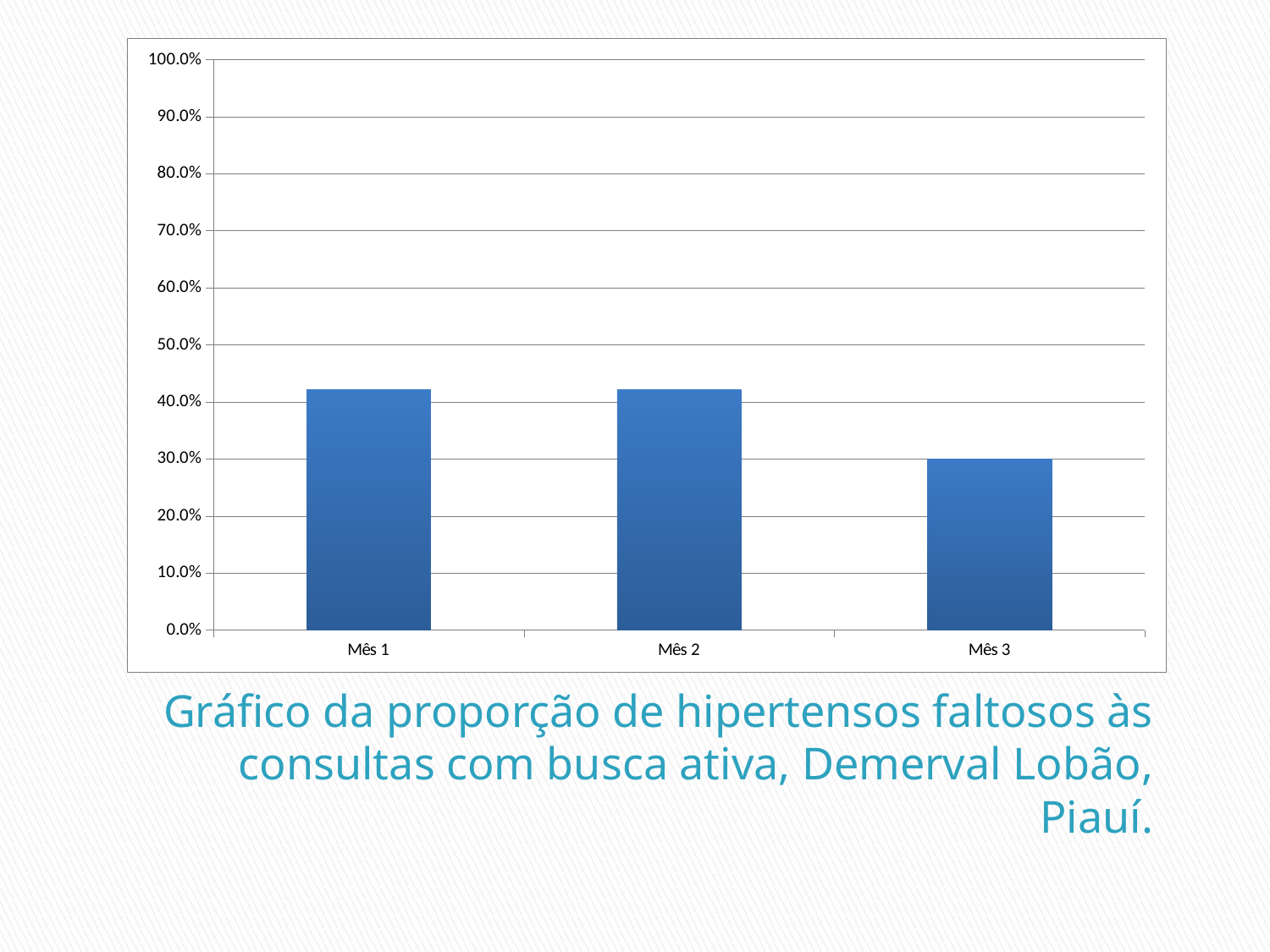
Is the value for Mês 2 greater or less than 50.0%? less Is the value for Mês 3 greater or less than 40.0%? less Is the value for Mês 3 greater or less than 20.0%? greater How many categories (months) are plotted on the x axis? 3 Does the value rise or fall from Mês 2 to Mês 3? fall What value does the bar for Mês 3 reach on the y axis? 30.0% Which is larger, the value for Mês 1 or the value for Mês 3? Mês 1 What is the highest value shown on the y axis? 100.0% According to the caption, which municipality and state does the chart refer to? Demerval Lobão, Piauí What kind of chart is shown on the slide? bar chart Which month has the lowest proportion of hypertensive patients missing appointments? Mês 3